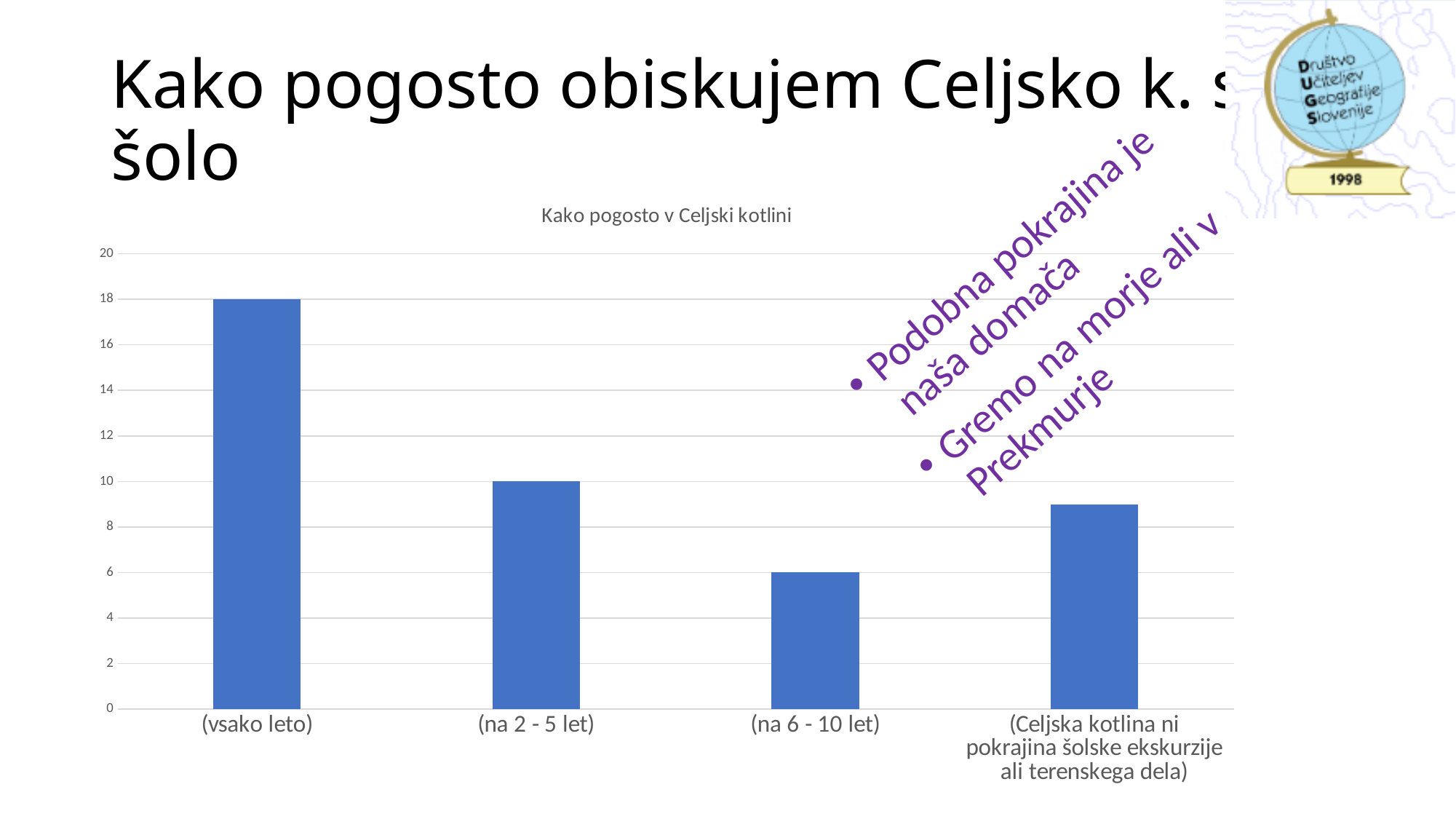
Which is larger, the value for (vsako leto) or the value for (na 6 - 10 let)? (vsako leto) What is the value for (na 2 - 5 let)? 10 Do the values rise or fall from (vsako leto) to (na 6 - 10 let)? fall What type of chart is shown on the slide? bar chart Which category has the lowest value? (na 6 - 10 let) What is the value for (vsako leto)? 18 Is the value for (Celjska kotlina ni pokrajina šolske ekskurzije ali terenskega dela) greater or less than 10? less What is the title of the chart? Kako pogosto v Celjski kotlini What is the difference between the values for (vsako leto) and (na 2 - 5 let)? 8 Which category has the highest value? (vsako leto) What is the value for (na 6 - 10 let)? 6 How many categories are shown on the x axis of the chart? 4